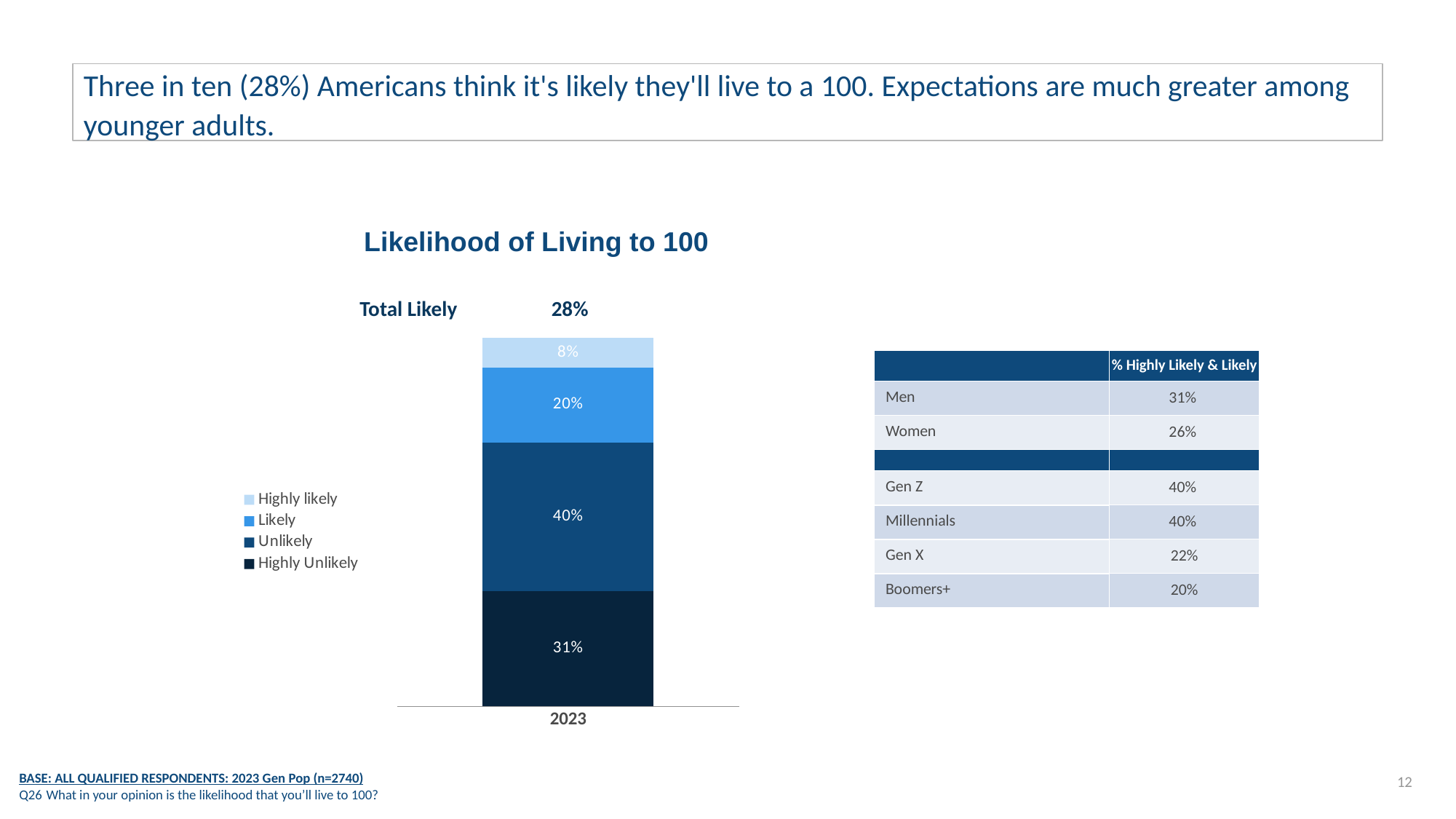
In the "Likelihood of Living to 100" chart, what percentage of respondents said "Highly Unlikely"? 31% What type of chart is shown under the title "Likelihood of Living to 100"? Stacked bar chart Which response category has the largest share in the "Likelihood of Living to 100" chart? Unlikely What year label appears on the x axis of the "Likelihood of Living to 100" chart? 2023 In the "Likelihood of Living to 100" chart, what percentage of respondents said "Likely"? 20% In the "Likelihood of Living to 100" chart, which is larger: the "Likely" share or the "Highly Unlikely" share? Highly Unlikely In the "Likelihood of Living to 100" chart, what percentage of respondents said "Unlikely"? 40% In the "Likelihood of Living to 100" chart, what is the difference between the "Unlikely" and "Highly Unlikely" shares? 9% How many series does the legend of the "Likelihood of Living to 100" chart list? 4 Which response category has the smallest share in the "Likelihood of Living to 100" chart? Highly likely What is the "Total Likely" figure shown above the bar in the "Likelihood of Living to 100" chart? 28% In the "Likelihood of Living to 100" chart, what percentage of respondents said "Highly likely"? 8%